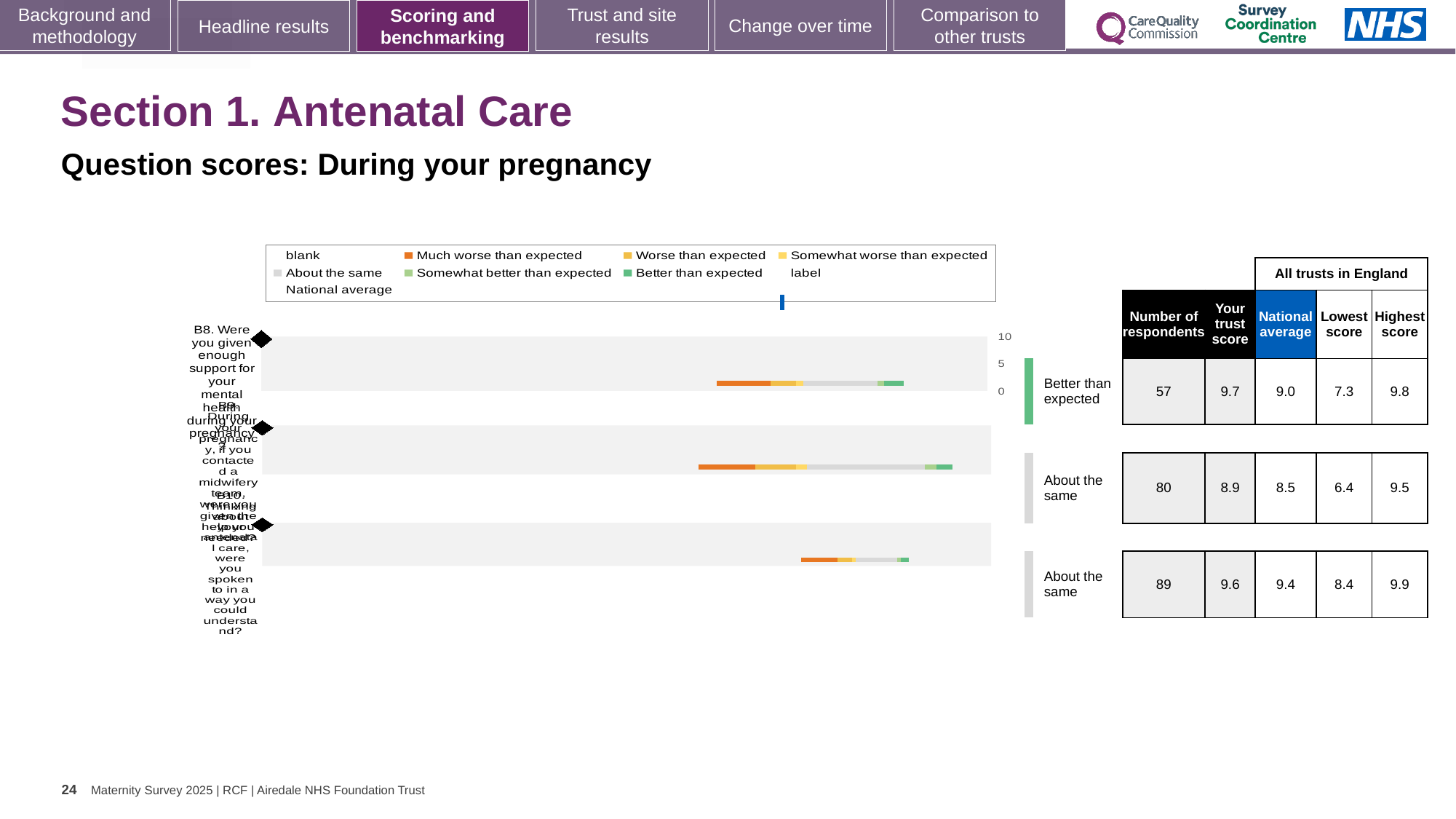
How many question bars are plotted in the chart? 3 In the table beside the chart, what is the highest score for the third (bottom) question row? 9.9 Which question row has the highest 'Your trust score' in the table beside the chart? the first (top) row, 9.7 In the chart legend, what colour represents 'Much worse than expected'? orange In the table beside the chart, what is 'Your trust score' for the first (top) question row? 9.7 What kind of chart is shown on the slide? bar chart For the first (top) question row, what is the difference between 'Your trust score' and the national average? 0.7 In the chart legend, what colour represents 'Better than expected'? green Which question row has the lowest 'Lowest score' in the table beside the chart? the second row, 6.4 In the table beside the chart, what is the national average for the second question row? 8.5 In the table beside the chart, what is the number of respondents for the first (top) question row? 57 For the second question row, which is larger: 'Your trust score' or the national average? Your trust score